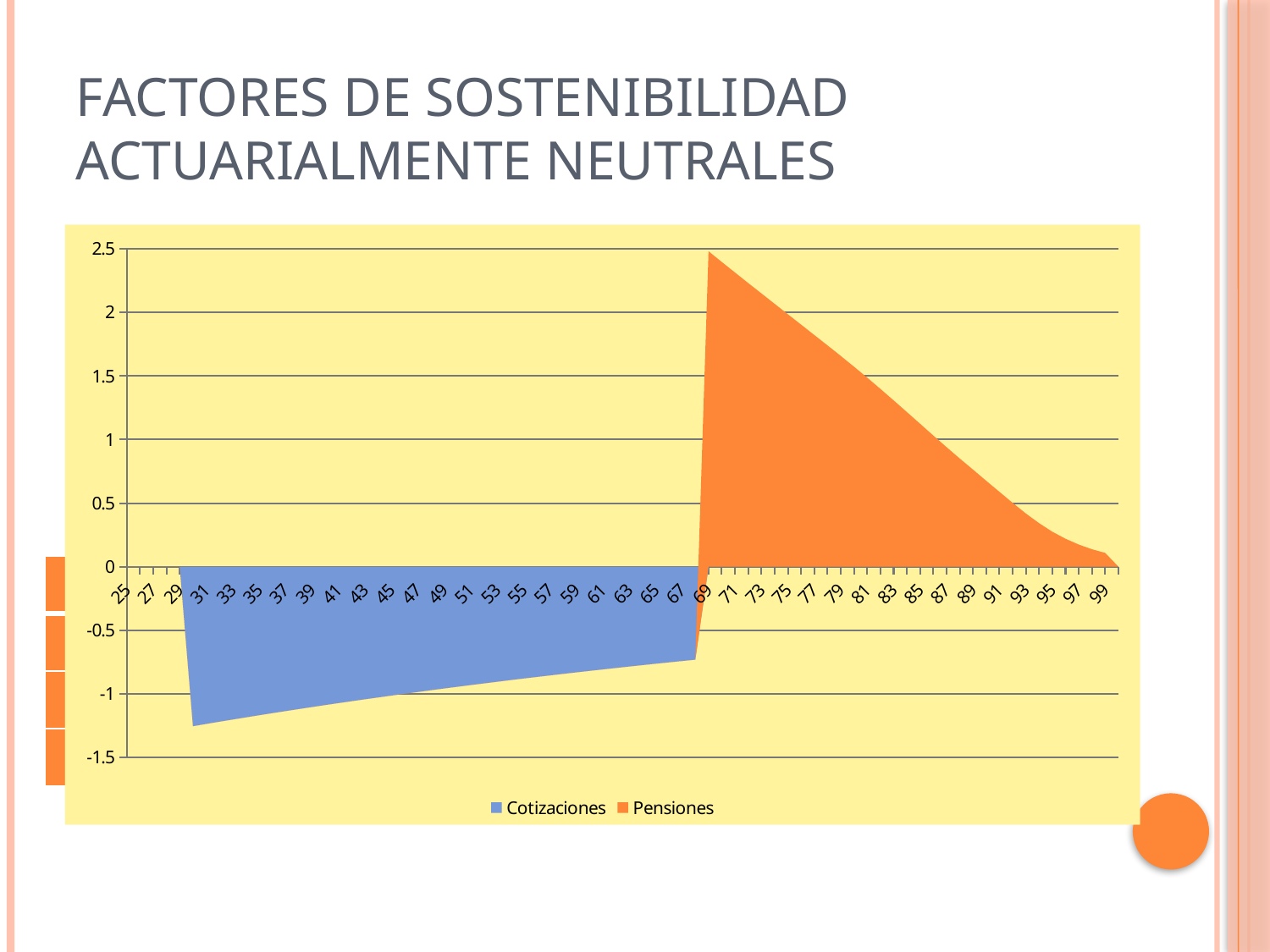
Is the value for Pensiones at 69 greater or less than 2? greater Is the value for Cotizaciones at 31 greater or less than -1? less Do the Pensiones values rise or fall as the x axis goes from 69 to 99? fall Which colour represents the Pensiones series? orange What kind of chart is shown on the slide? area chart Is the value for Pensiones at 89 greater or less than 1? less How many series does the legend list? 2 What are the two series named in the legend? Cotizaciones and Pensiones Which is larger, the Pensiones value at 71 or at 91? 71 Which series has values below zero? Cotizaciones